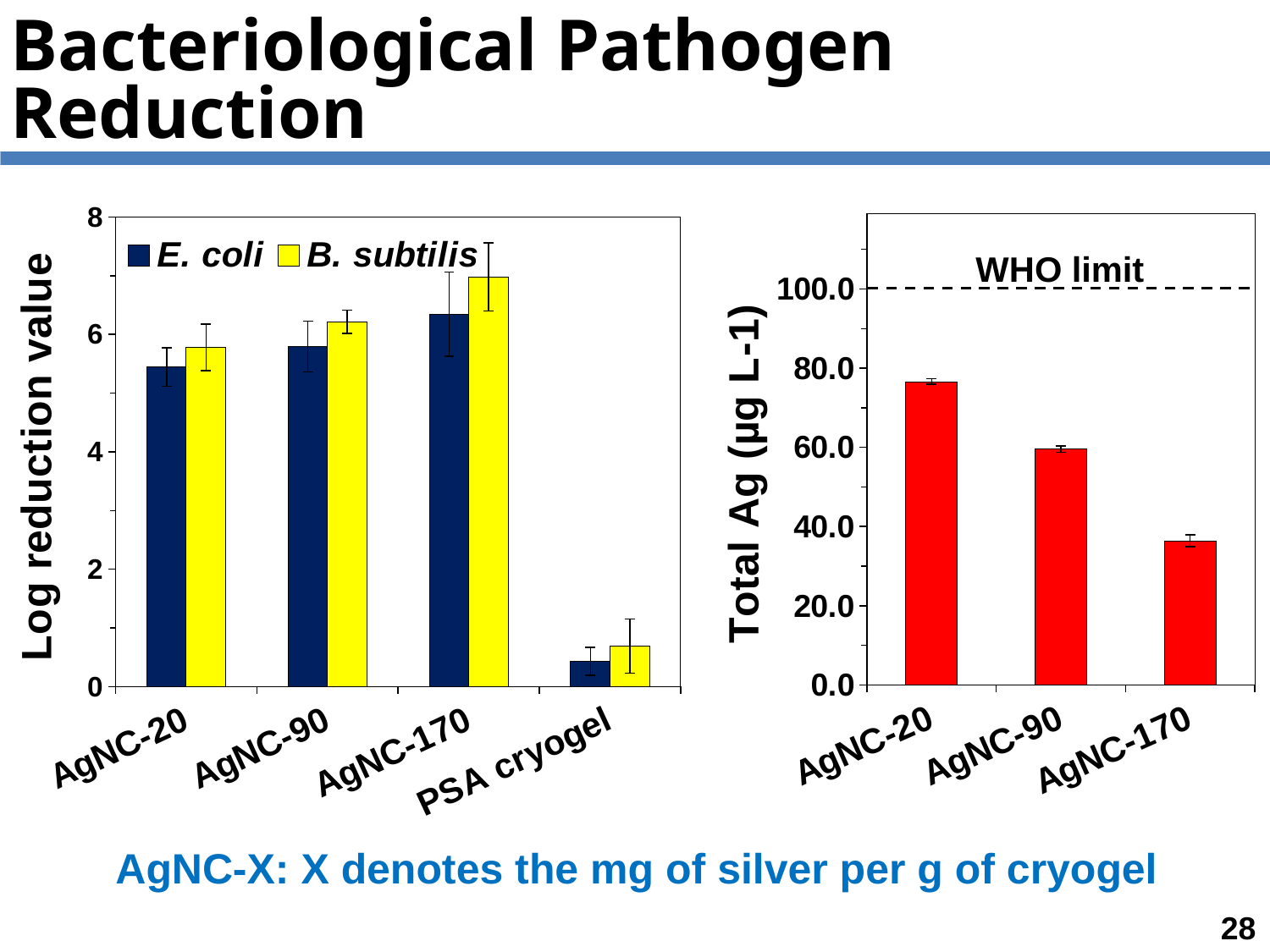
In the right chart (Total Ag), how many categories are shown on the x axis? 3 In the left chart (Log reduction value), how many categories are shown on the x axis? 4 In the left chart (Log reduction value), which category has the lowest E. coli value? PSA cryogel In the right chart (Total Ag), is the value for AgNC-170 greater or less than 40.0? less In the left chart (Log reduction value), is the B. subtilis value for PSA cryogel greater or less than 2? less In the right chart (Total Ag), do the values rise or fall from AgNC-20 to AgNC-170? fall In the left chart (Log reduction value), which category has the highest B. subtilis value? AgNC-170 In the left chart (Log reduction value), how many series does the legend list? 2 In the left chart (Log reduction value), is the E. coli value for AgNC-20 greater or less than 4? greater In the right chart (Total Ag), at what value is the dashed WHO limit line drawn? 100.0 In the right chart (Total Ag), which category has the highest value? AgNC-20 What kind of chart is the left chart (Log reduction value)? bar chart